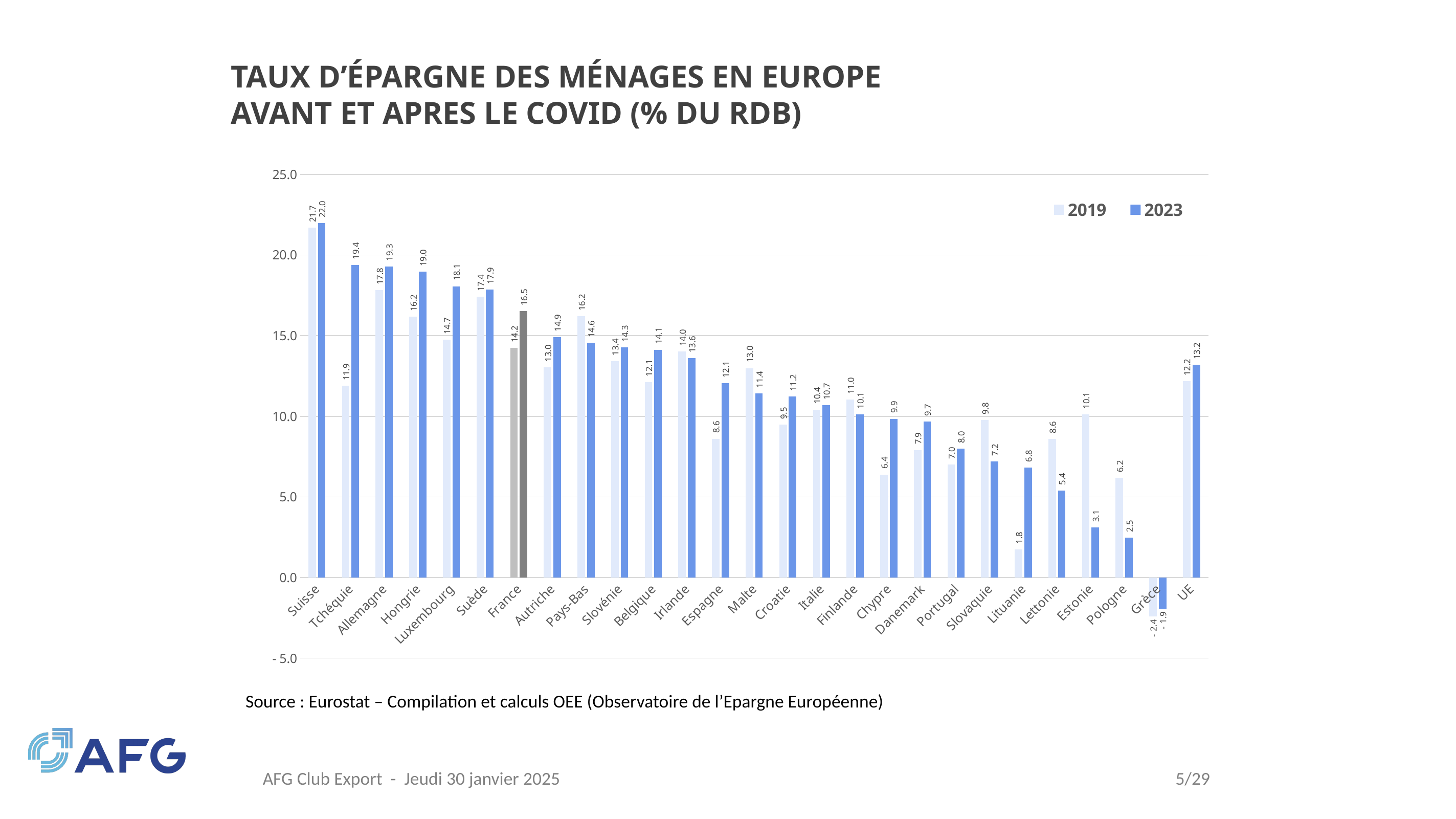
Which country has the lowest 2019 value? Grèce How many series does the legend list? 2 What kind of chart is shown on the slide? bar chart Is the 2023 value for Lituanie greater or less than 5.0? greater Which is larger for Estonie, the 2019 value or the 2023 value? 2019 How many categories are shown on the x axis? 27 Which country's bars are shown in grey instead of blue? France What is the difference between the 2023 and 2019 values for Tchéquie? 7.5 Which country has the highest 2023 value? Suisse What is the 2023 value for UE? 13.2 What is the 2019 value for Tchéquie? 11.9 What is the 2023 value for France? 16.5